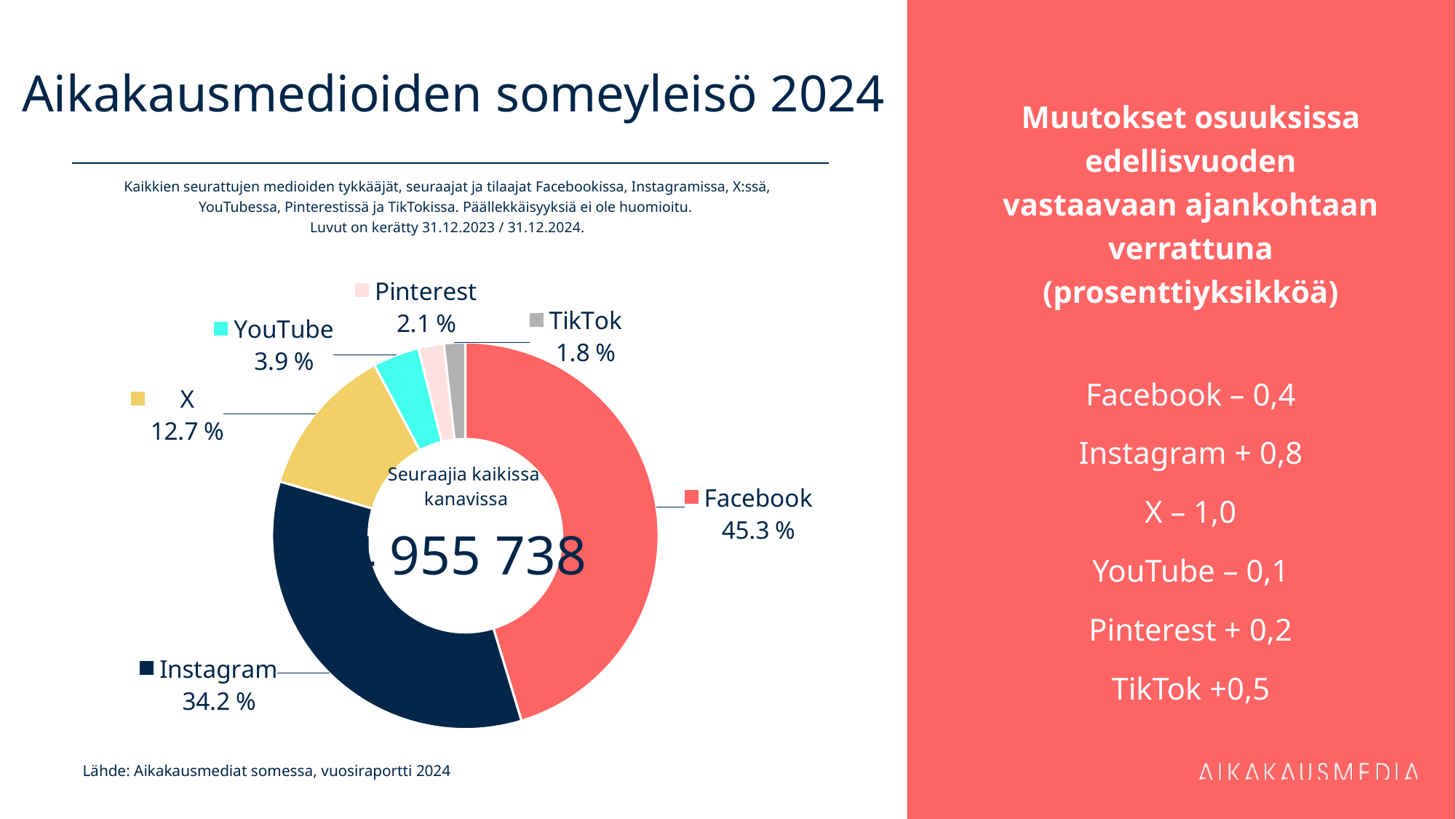
What share does X have in the chart? 12.7 % What is the difference in percentage points between Facebook's and Instagram's shares? 11.1 % What kind of chart is shown on the slide? Pie chart (donut) Which platform has the largest share in the chart? Facebook Which has a larger share, X or YouTube? X What share does TikTok have in the chart? 1.8 % What share of the social media audience does Instagram have? 34.2 % What share does YouTube have in the chart? 3.9 % Which platform has the smallest share in the chart? TikTok How many platforms (slices) are shown in the chart? 6 What is the title of the slide containing the chart? Aikakausmedioiden someyleisö 2024 What share of the social media audience does Facebook have? 45.3 %